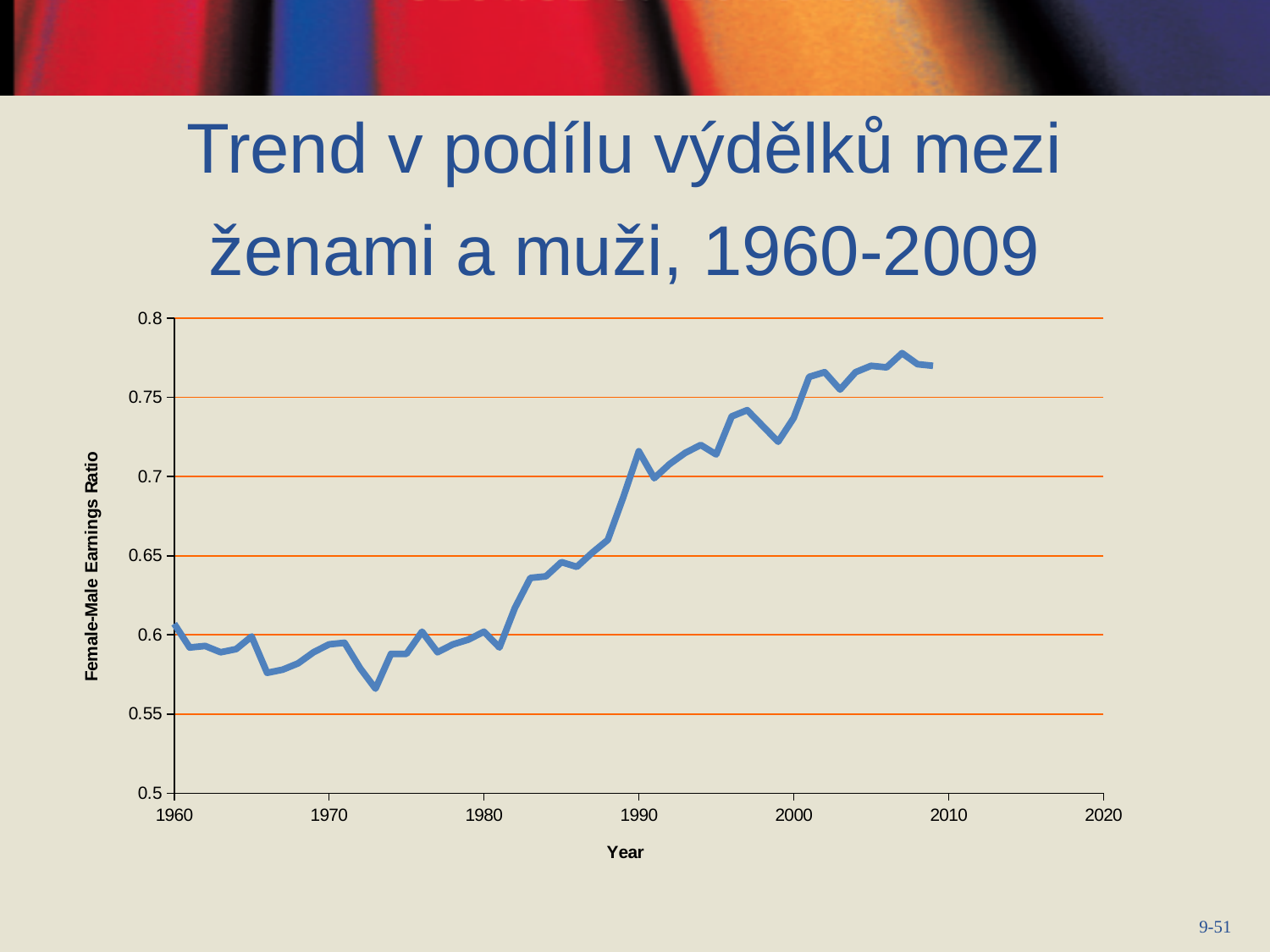
Which year has the higher Female-Male Earnings Ratio, 1960 or 2000? 2000 Is the Female-Male Earnings Ratio in 1990 greater or less than 0.7? greater What is the label of the horizontal axis? Year What kind of chart is shown on the slide? line chart Is the Female-Male Earnings Ratio in 2009 greater or less than 0.75? greater Does the Female-Male Earnings Ratio generally rise or fall from 1960 to 2009? rise Is the Female-Male Earnings Ratio in 1960 greater or less than 0.65? less What is the label of the vertical axis? Female-Male Earnings Ratio Which year has the higher Female-Male Earnings Ratio, 1980 or 1990? 1990